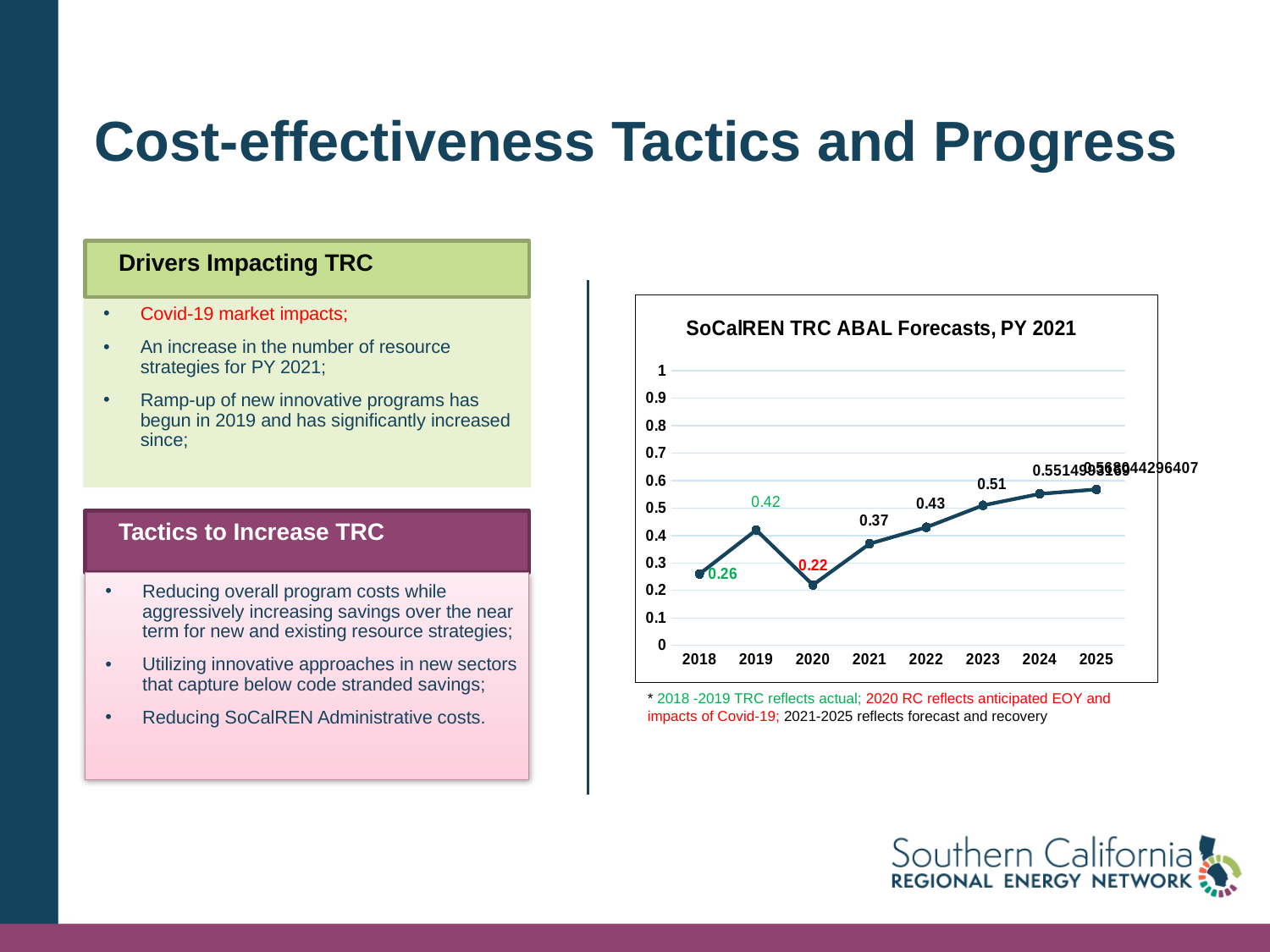
What is the TRC value for 2022? 0.43 Is the value for 2025 greater or less than 0.5? greater What is the TRC value for 2018? 0.26 What is the TRC value for 2023? 0.51 What type of chart is shown on the slide? line chart What is the difference between the TRC values for 2019 and 2018? 0.16 What is the TRC value for 2019? 0.42 Which year has the larger TRC value, 2019 or 2020? 2019 What is the TRC value for 2020? 0.22 How many years are plotted on the x axis? 8 What is the title of the chart? SoCalREN TRC ABAL Forecasts, PY 2021 Which year has the lowest TRC value? 2020